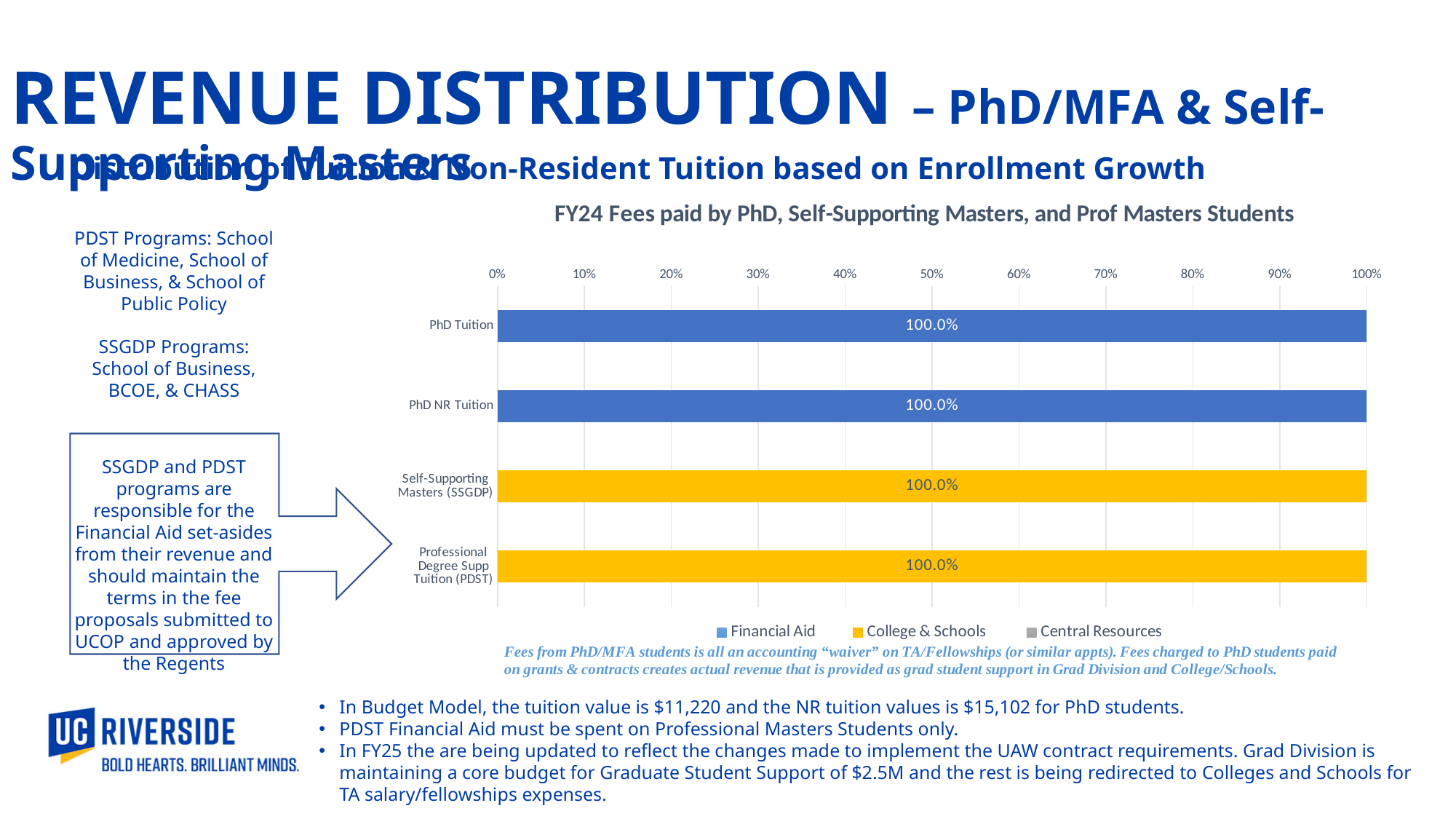
What is the Financial Aid share shown for PhD Tuition? 100.0% What is the College & Schools share shown for Self-Supporting Masters (SSGDP)? 100.0% Which series makes up the entire bar for Self-Supporting Masters (SSGDP)? College & Schools What kind of chart is shown on the slide? Bar chart What is the College & Schools share shown for Professional Degree Supp Tuition (PDST)? 100.0% What is the title of the chart? FY24 Fees paid by PhD, Self-Supporting Masters, and Prof Masters Students Which legend series is shown in yellow? College & Schools Which series makes up the entire bar for PhD Tuition? Financial Aid What is the Financial Aid share shown for PhD NR Tuition? 100.0% How many categories (bars) are plotted in the chart? 4 What is the total of the stacked bar for PhD NR Tuition? 100.0% How many series does the chart's legend list? 3